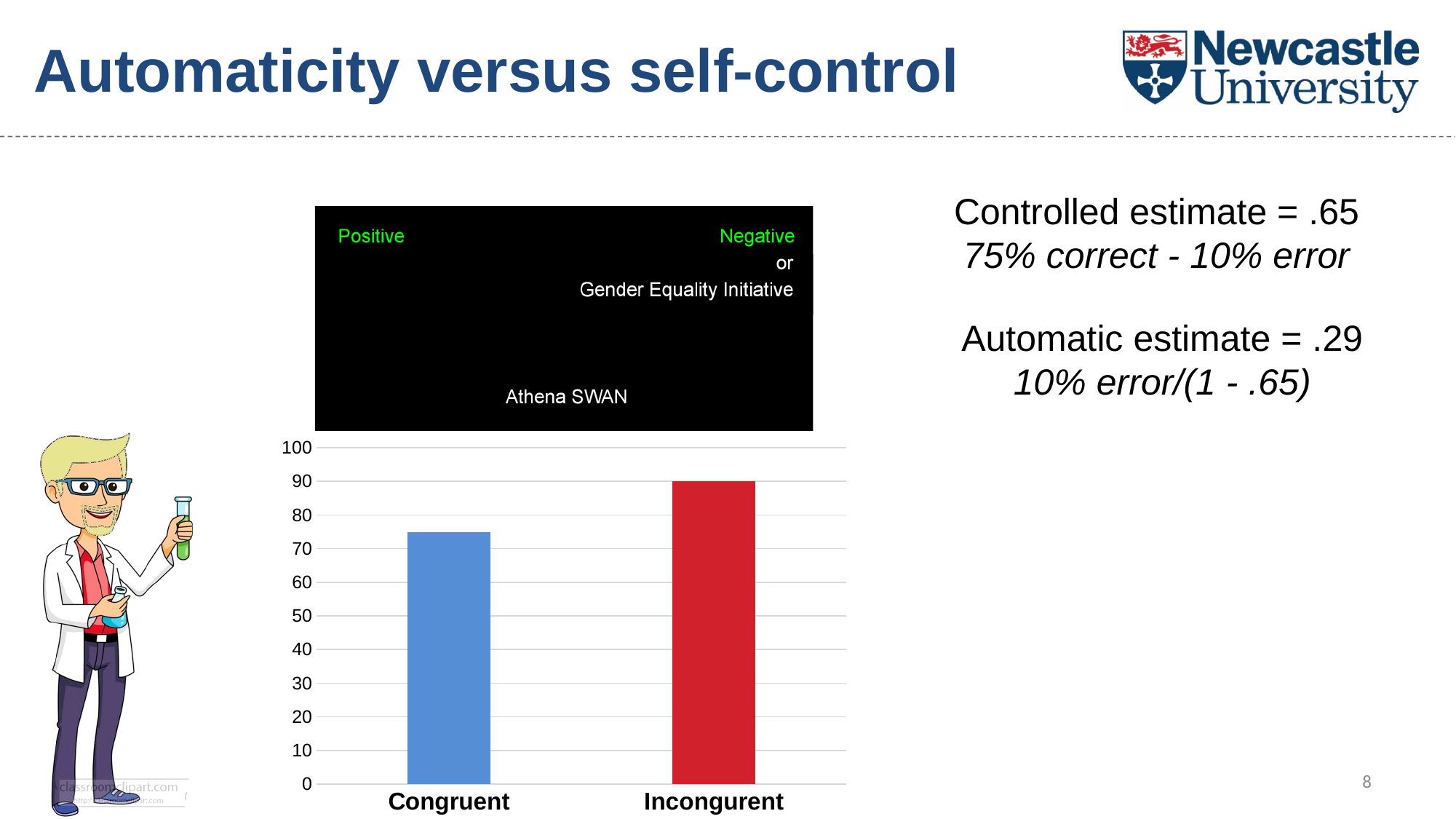
How many categories are shown on the x axis of the bar chart? 2 Which is larger, the value for Congruent or the value for Incongurent? Incongurent Is the value for Incongurent greater or less than 80? greater What colour is the bar for Incongurent? red Which category has the highest bar in the chart? Incongurent What kind of chart is shown on the slide? bar chart What is the value for Incongurent in the bar chart? 90 Which category has the lowest bar in the chart? Congruent What is the maximum value shown on the y axis of the bar chart? 100 Is the value for Congruent greater or less than 80? less Is the value for Congruent greater or less than 70? greater